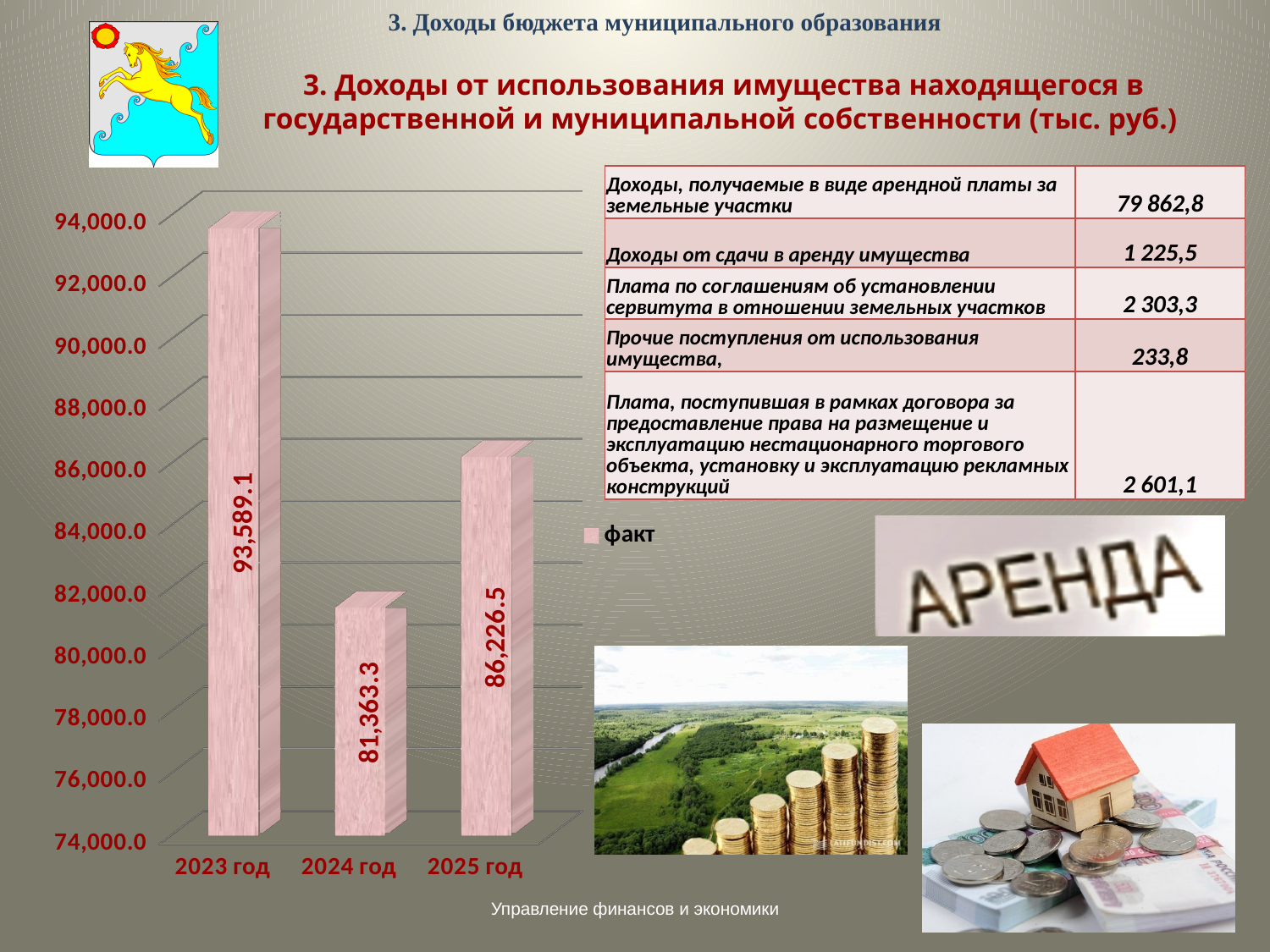
What kind of chart is shown? bar chart Which year has the lowest value? 2024 год What is the value for 2025 год? 86,226.5 What is the difference between the values for 2023 год and 2024 год? 12,225.8 Which is larger, the value for 2025 год or the value for 2024 год? 2025 год How many years are shown on the chart? 3 What is the value for 2024 год? 81,363.3 Which year has the highest value? 2023 год Is the value for 2024 год greater or less than 82,000.0? less What is the difference between the values for 2025 год and 2024 год? 4,863.2 What is the value for 2023 год? 93,589.1 What series name does the legend show? факт